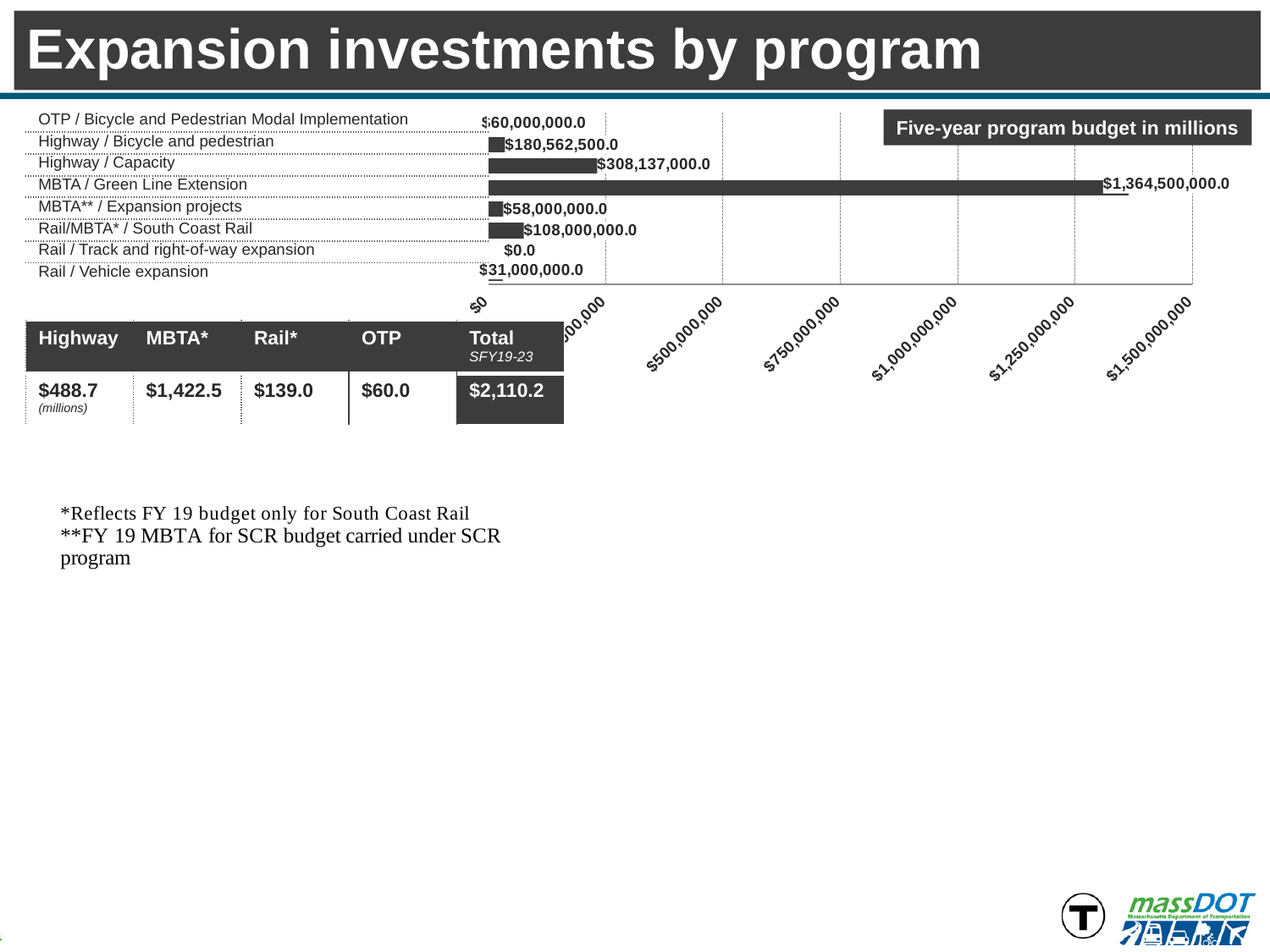
Which category has the lowest value? Rail / Track and right-of-way expansion Which category has the highest value? MBTA / Green Line Extension How many categories are shown in the chart? 8 What is the value for Highway / Bicycle and pedestrian? $180,562,500.0 What is the value for Rail/MBTA* / South Coast Rail? $108,000,000.0 What kind of chart is shown on the slide? bar chart What is the difference between Highway / Capacity and Highway / Bicycle and pedestrian? $127,574,500.0 What is the difference between OTP / Bicycle and Pedestrian Modal Implementation and MBTA** / Expansion projects? $2,000,000.0 What is the value for MBTA / Green Line Extension? $1,364,500,000.0 Is the value for MBTA / Green Line Extension greater or less than $1,250,000,000? greater What is the value for Highway / Capacity? $308,137,000.0 Which is larger, Rail/MBTA* / South Coast Rail or Rail / Vehicle expansion? Rail/MBTA* / South Coast Rail